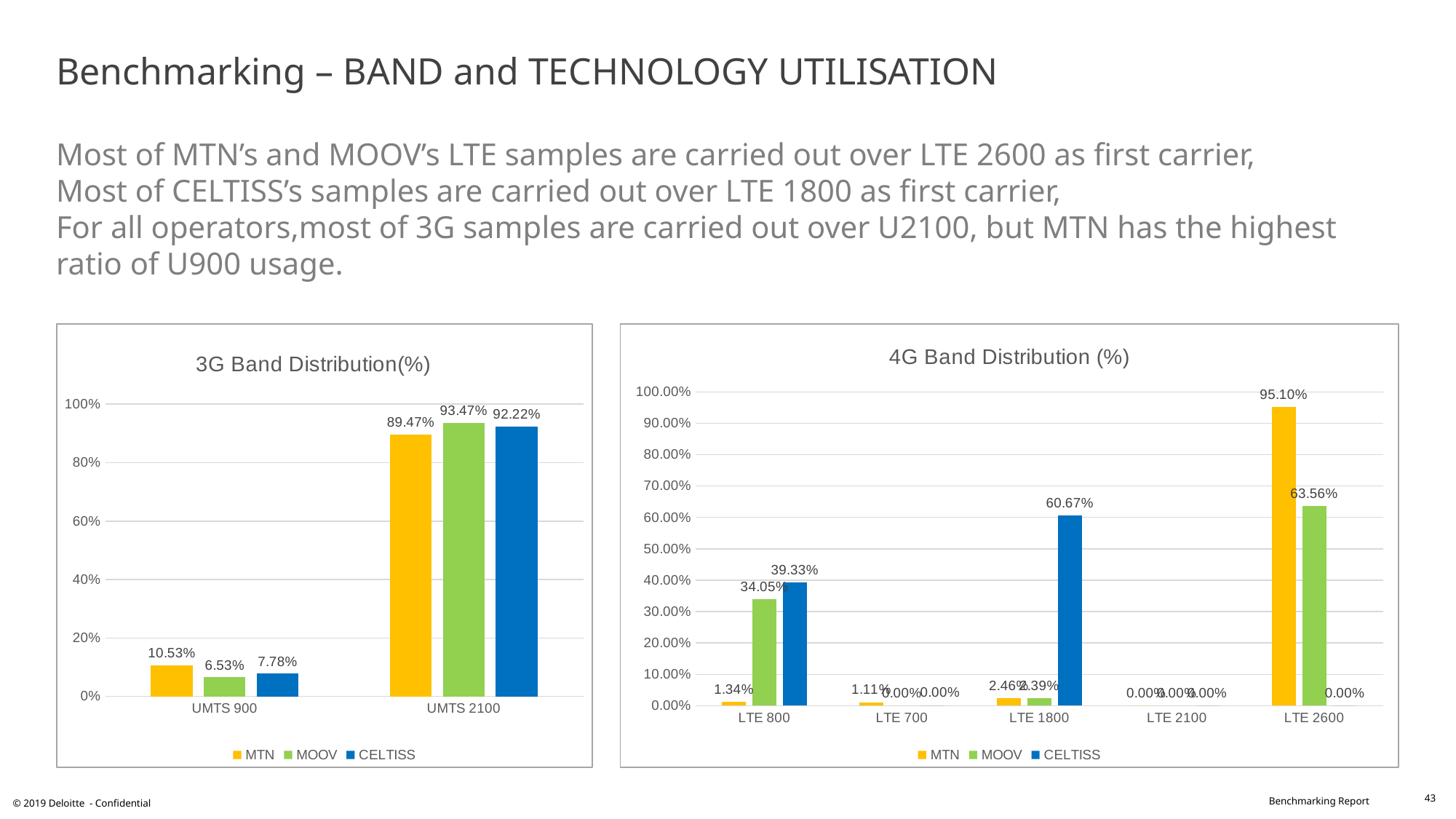
In the 4G Band Distribution (%) chart, what is the value for MTN on LTE 2600? 95.10% In the 4G Band Distribution (%) chart, what is the difference between MTN and MOOV on LTE 2600? 31.54% In the 4G Band Distribution (%) chart, is the value for MOOV on LTE 800 greater or less than 30.00%? greater In the 3G Band Distribution(%) chart, how many series does the legend list? 3 In the 3G Band Distribution(%) chart, what is the value for MOOV on UMTS 2100? 93.47% In the 3G Band Distribution(%) chart, what is the value for MTN on UMTS 900? 10.53% In the 4G Band Distribution (%) chart, how many band categories are shown on the x axis? 5 In the 4G Band Distribution (%) chart, what is the value for CELTISS on LTE 1800? 60.67% What kind of chart is the 4G Band Distribution (%) chart? Bar chart In the 3G Band Distribution(%) chart, which operator has the highest value on UMTS 2100? MOOV In the 4G Band Distribution (%) chart, which operator has the highest value on LTE 800? CELTISS In the 3G Band Distribution(%) chart, what is the difference between MTN and MOOV on UMTS 900? 4.00%